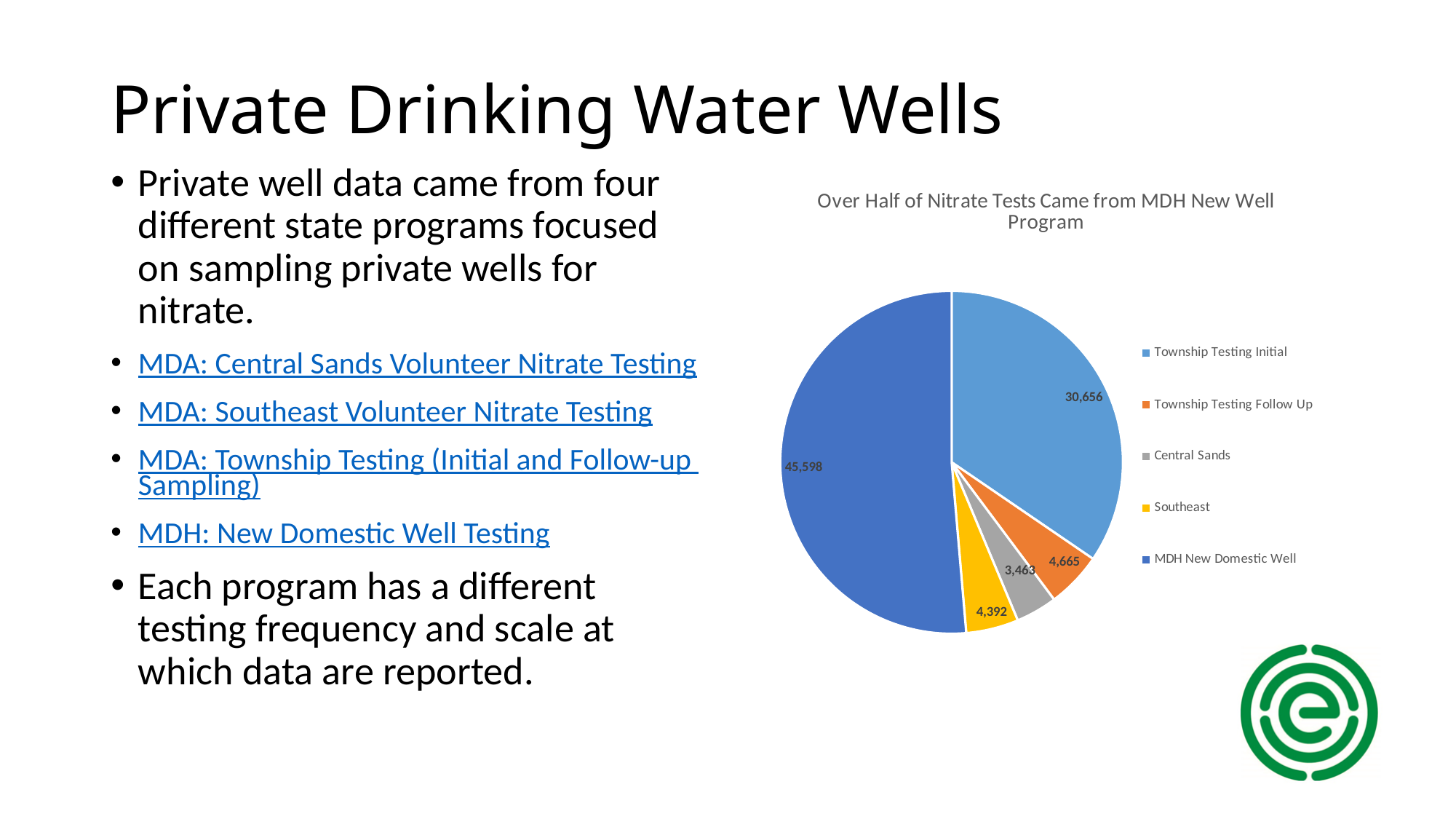
What is the title of the chart? Over Half of Nitrate Tests Came from MDH New Well Program What is the value for Central Sands? 3,463 Which legend entry is shown in orange? Township Testing Follow Up What is the difference between the MDH New Domestic Well value and the Township Testing Initial value? 14,942 Which is larger, Township Testing Follow Up or Southeast? Township Testing Follow Up Which program has the largest slice of the pie? MDH New Domestic Well How many slices does the pie chart have? 5 Which program has the smallest slice of the pie? Central Sands What is the value for Township Testing Initial? 30,656 What type of chart is shown on the slide? pie chart What is the value for MDH New Domestic Well? 45,598 What is the value for Southeast? 4,392